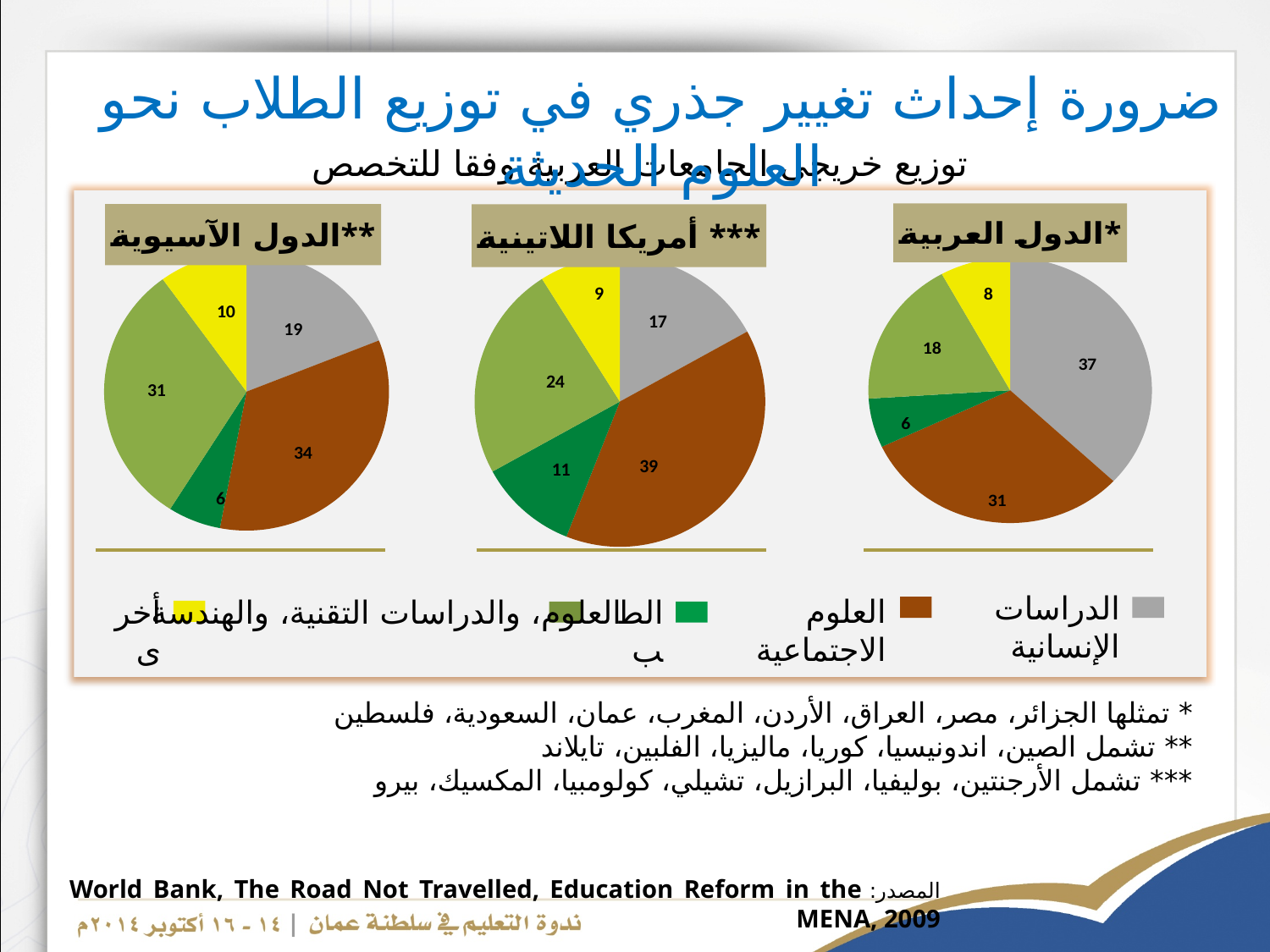
What is the difference between the social sciences value in the Latin America chart and the social sciences value in the Arab countries chart? 8 Which is larger: the medicine (الطب) value in the Latin America chart or in the Arab countries chart? Latin America (أمريكا اللاتينية) In the Latin America (أمريكا اللاتينية) pie chart, what is the value for social sciences (العلوم الاجتماعية)? 39 Which colour represents medicine (الطب) in the legend? Dark green In the Arab countries (الدول العربية) pie chart, which category has the largest slice? الدراسات الإنسانية How many pie charts are shown on the slide? 3 What type of chart is used on this slide? Pie chart In the Asian countries (الدول الآسيوية) pie chart, which category has the smallest slice? الطب In the Arab countries (الدول العربية) pie chart, what is the value for humanities studies (الدراسات الإنسانية)? 37 In the Latin America (أمريكا اللاتينية) pie chart, which category has the smallest slice? أخرى How many slices does each pie chart on the slide have? 5 In the Asian countries (الدول الآسيوية) pie chart, what is the value for science, technical studies and engineering (العلوم والدراسات التقنية والهندسة)? 31